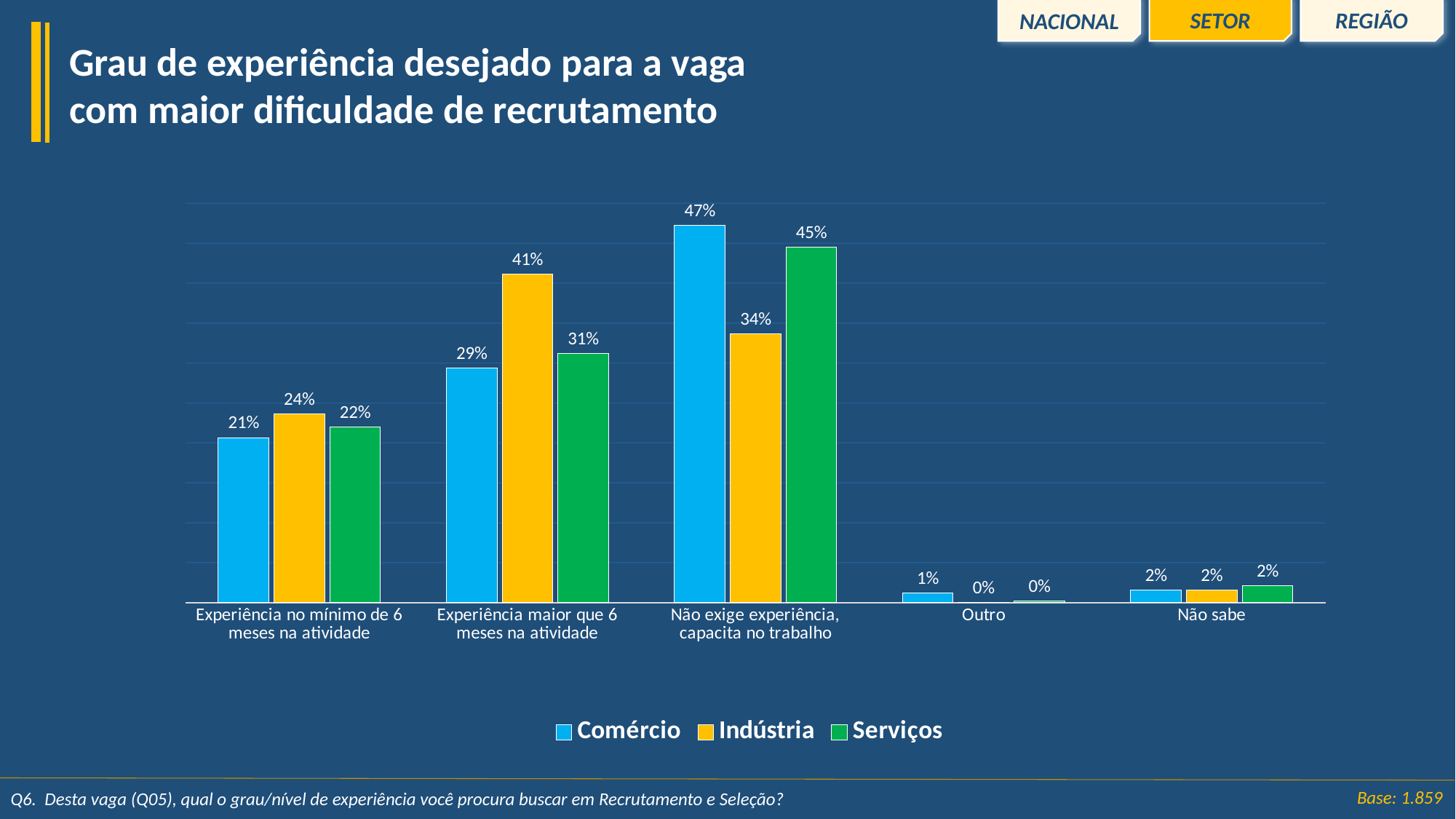
What is the value for Serviços in the category 'Experiência no mínimo de 6 meses na atividade'? 22% How many categories are shown on the x axis? 5 Which category has the lowest value for Comércio? Outro Which colour represents Serviços in the legend? Green What kind of chart is shown on the slide? Bar chart How many series does the legend list? 3 In the category 'Experiência maior que 6 meses na atividade', which is larger: Indústria or Serviços? Indústria What is the value for Comércio in the category 'Não exige experiência, capacita no trabalho'? 47% Which category has the highest value for Indústria? Experiência maior que 6 meses na atividade What is the value for Indústria in the category 'Outro'? 0% What is the value for Indústria in the category 'Experiência maior que 6 meses na atividade'? 41% What is the difference between the Comércio and Indústria values in the category 'Não exige experiência, capacita no trabalho'? 13%